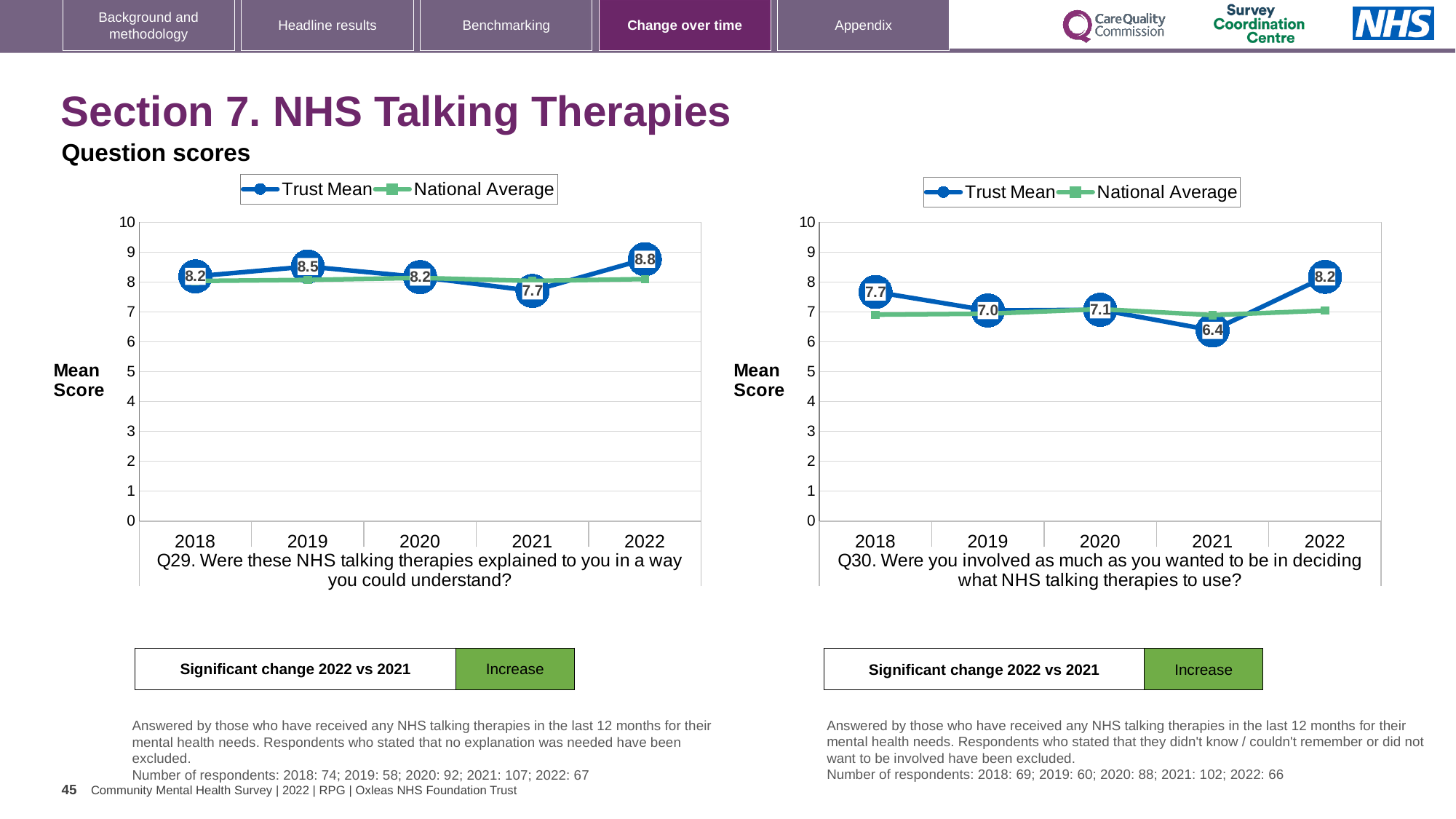
In the Q30 chart on the right, which year has the lowest Trust Mean score? 2021 In the Q29 chart on the left, which year has the lowest Trust Mean score? 2021 In the Q29 chart on the left, what is the difference between the Trust Mean scores for 2022 and 2021? 1.1 In the Q29 chart on the left, what is the Trust Mean score for 2021? 7.7 In the Q29 chart on the left, what is the Trust Mean score for 2022? 8.8 In the Q29 chart on the left, which year has the highest Trust Mean score? 2022 In the Q30 chart on the right, is the Trust Mean score for 2022 greater or less than 8? greater In the Q30 chart on the right, what is the Trust Mean score for 2021? 6.4 In the Q30 chart on the right, which is larger: the Trust Mean score for 2019 or for 2022? 2022 What type of chart is the Q30 chart on the right? Line chart In the Q30 chart on the right, what is the Trust Mean score for 2018? 7.7 How many years are plotted on the x axis of the Q29 chart on the left? 5